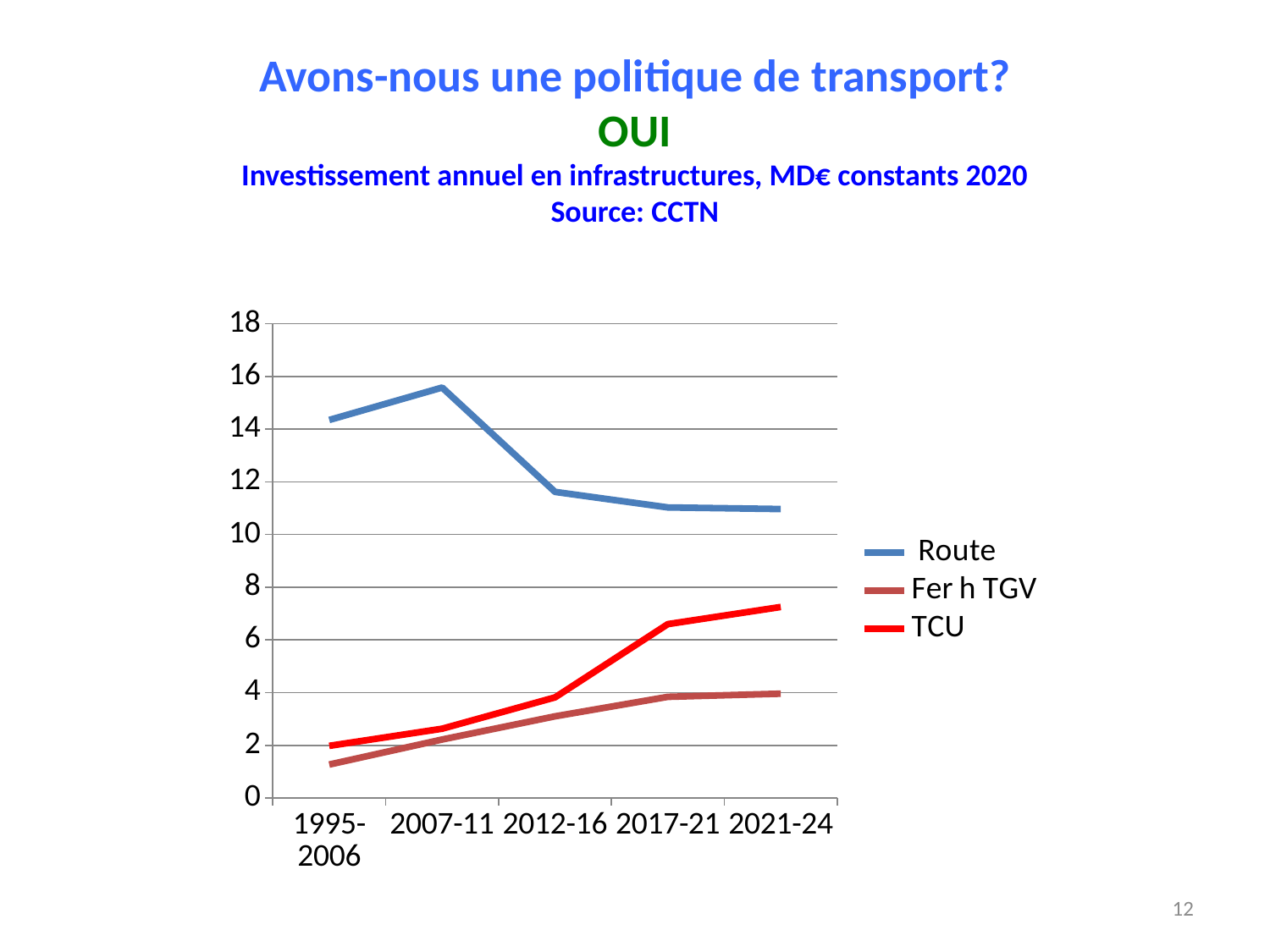
Is the value for Route in 2007-11 greater or less than 14? greater What kind of chart is shown on the slide? line chart What source is cited for the chart data? CCTN In which period does the Route series reach its highest value? 2007-11 How many series does the legend list? 3 Is the value for TCU in 2021-24 greater or less than 8? less In which period is the TCU series at its lowest? 1995-2006 Does the TCU series rise or fall from 1995-2006 to 2021-24? rise How many periods are shown on the x axis? 5 Which series has the highest values across the chart? Route Which is larger in 2017-21, TCU or Fer h TGV? TCU Which is larger in 2021-24, Route or TCU? Route